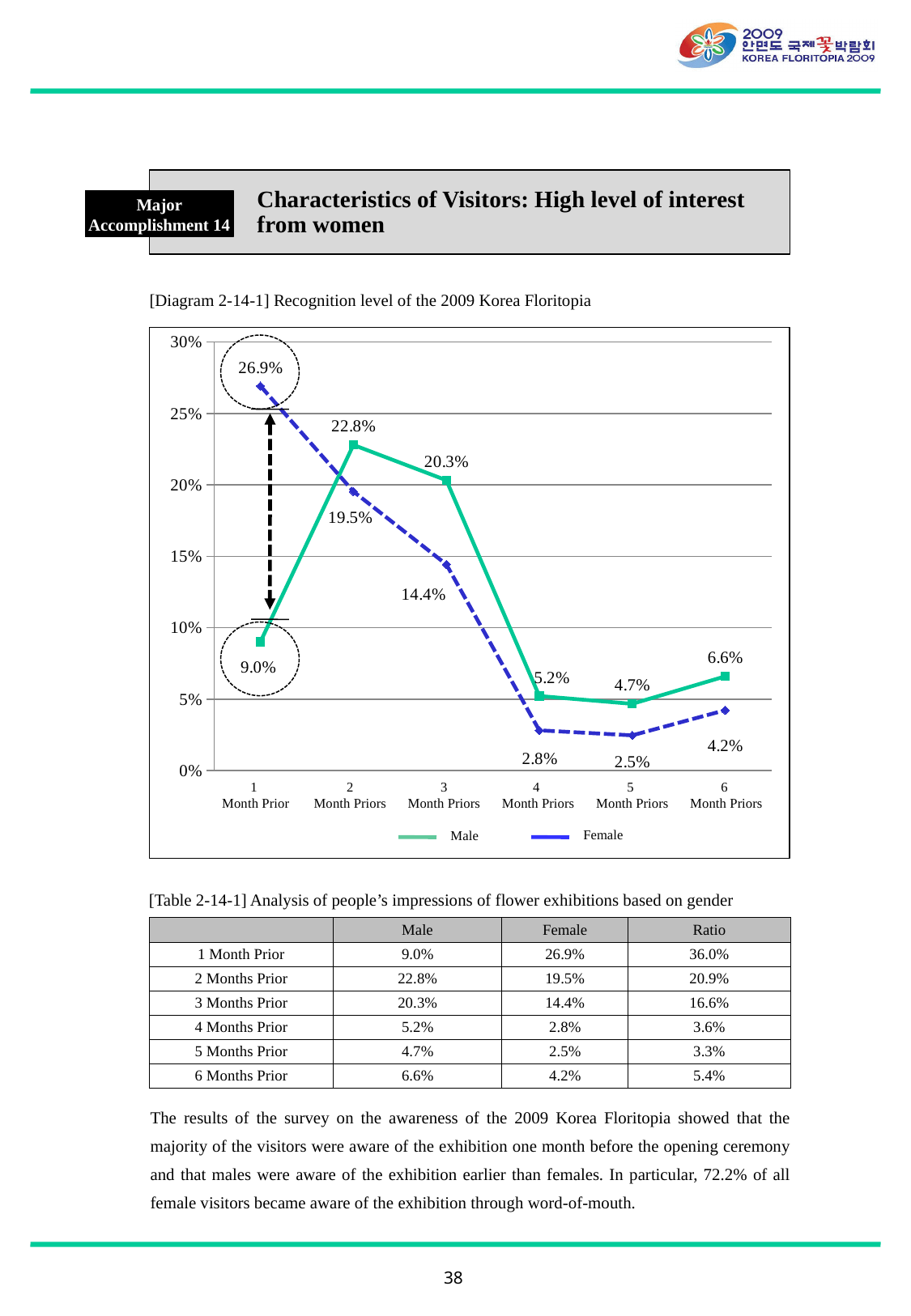
What is the Male value at 3 Months Prior? 20.3% At which category is the Male series highest? 2 Months Prior What is the Female value at 1 Month Prior? 26.9% What type of chart is shown in Diagram 2-14-1? Line chart At which category is the Female series lowest? 5 Months Prior Does the Male series rise or fall from 2 Months Prior to 5 Months Prior? Fall How many categories are plotted along the x axis of the chart? 6 How many series does the legend of the chart list? 2 Which is larger at 4 Months Prior, the Male value or the Female value? Male What is the difference between the Female and Male values at 1 Month Prior? 17.9% Which series is drawn with a dashed line in the chart? Female What is the Female value at 5 Months Prior? 2.5%